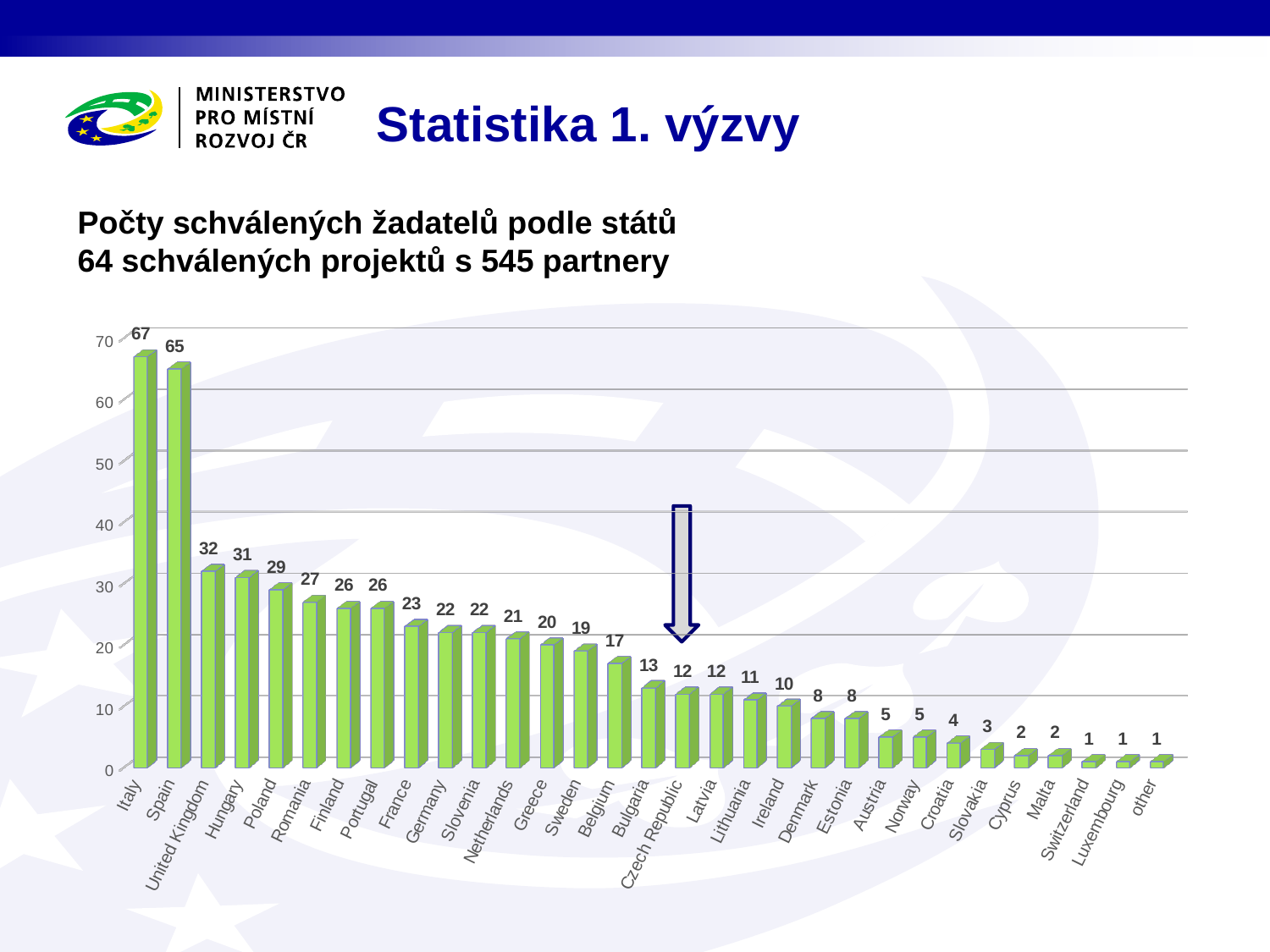
What is the value for Italy? 67 Which is larger, the value for Hungary or the value for Poland? Hungary Do the values rise or fall from left to right along the x axis? Fall What is the difference between the values for United Kingdom and Czech Republic? 20 Which is larger, the value for Bulgaria or the value for Ireland? Bulgaria What is the value for Germany? 22 What is the value for Czech Republic? 12 How many categories are shown on the x axis? 31 Which country has the highest value? Italy Which country does the arrow above the chart point to? Czech Republic What is the difference between the values for Italy and Spain? 2 What kind of chart is shown on the slide? Bar chart